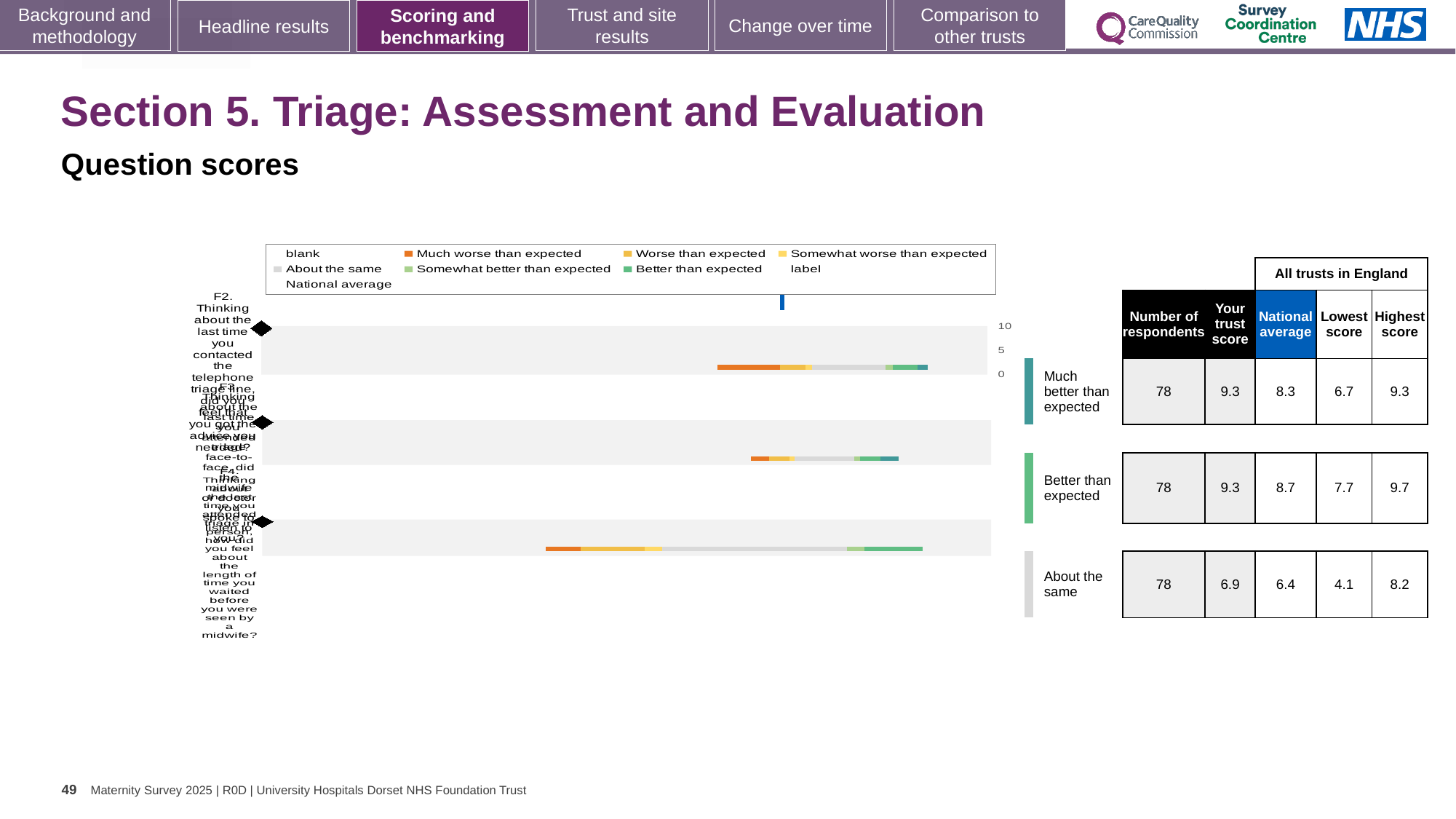
What is the number of respondents for the row labelled 'Much better than expected'? 78 Which is larger for the row labelled 'Much better than expected': 'Your trust score' or the national average? Your trust score What is 'Your trust score' for the row labelled 'Better than expected'? 9.3 What is the lowest score for the row labelled 'Much better than expected'? 6.7 What is the national average for the row labelled 'About the same'? 6.4 What is the highest score for the row labelled 'Better than expected'? 9.7 What kind of chart is shown on the slide? bar chart What is the difference between the highest score and the lowest score for the row labelled 'About the same'? 4.1 How many rows of scores are shown in the table next to the chart? 3 What is the difference between 'Your trust score' and the national average for the row labelled 'About the same'? 0.5 Which row has the lowest 'Your trust score'? About the same In the legend, what colour represents 'Much worse than expected'? orange